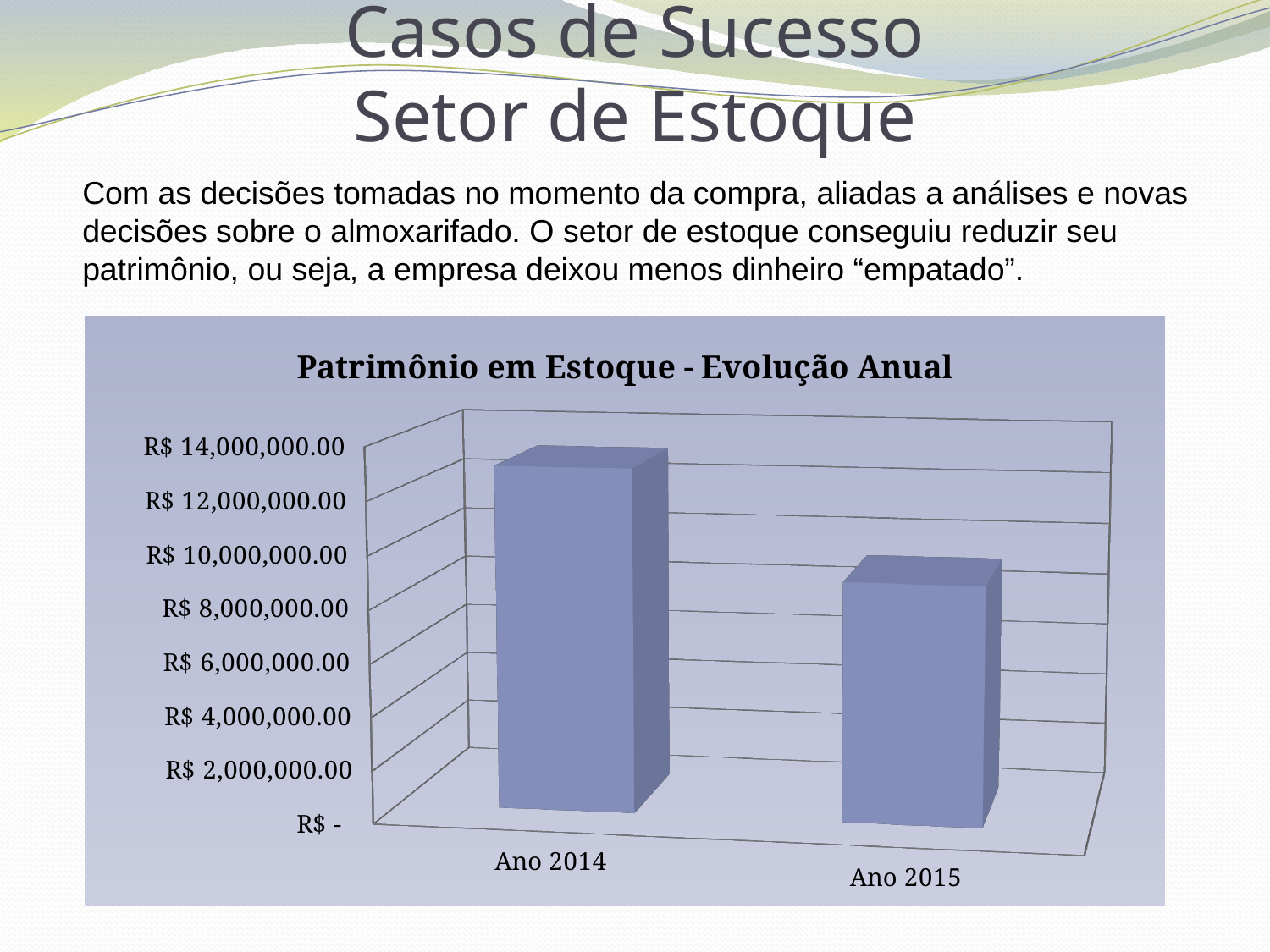
How many categories are plotted on the x axis of the chart? 2 What is the highest value labelled on the vertical axis of the chart? R$ 14,000,000.00 Do the values rise or fall from Ano 2014 to Ano 2015? fall Is the value for Ano 2015 greater or less than R$ 6,000,000.00? greater Which is larger, the value for Ano 2014 or the value for Ano 2015? Ano 2014 What kind of chart is shown on the slide? bar chart Is the value for Ano 2014 greater or less than R$ 10,000,000.00? greater Which year has the lowest value in the chart? Ano 2015 What is the title of the chart? Patrimônio em Estoque - Evolução Anual Is the value for Ano 2015 greater or less than R$ 12,000,000.00? less Which year has the highest value in the chart? Ano 2014